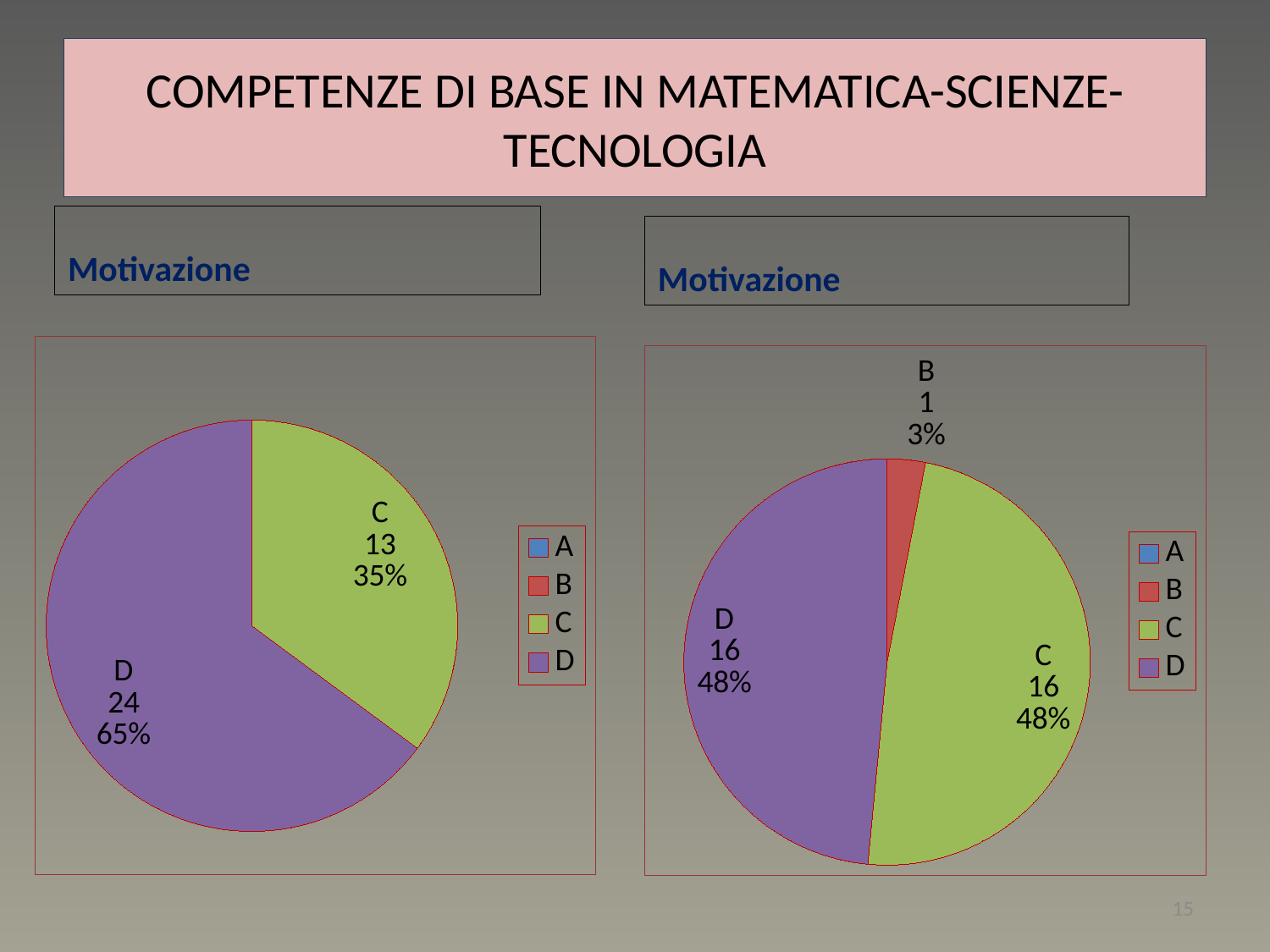
How many entries does the legend of the right pie chart list? 4 In the left pie chart, what is the value for category D? 24 In the left pie chart, which category has the largest slice? D In the left pie chart, what share of the pie does category D represent? 65% In the right pie chart, what is the difference between the values for C and B? 15 In the right pie chart, which category has the smallest slice? B In the left pie chart, what share of the pie does category C represent? 35% In the right pie chart, what share of the pie does category C represent? 48% In the left pie chart, what is the difference between the values for D and C? 11 What kind of chart is the left chart on the slide? pie chart In the left pie chart, what is the value for category C? 13 In the right pie chart, what is the value for category B? 1